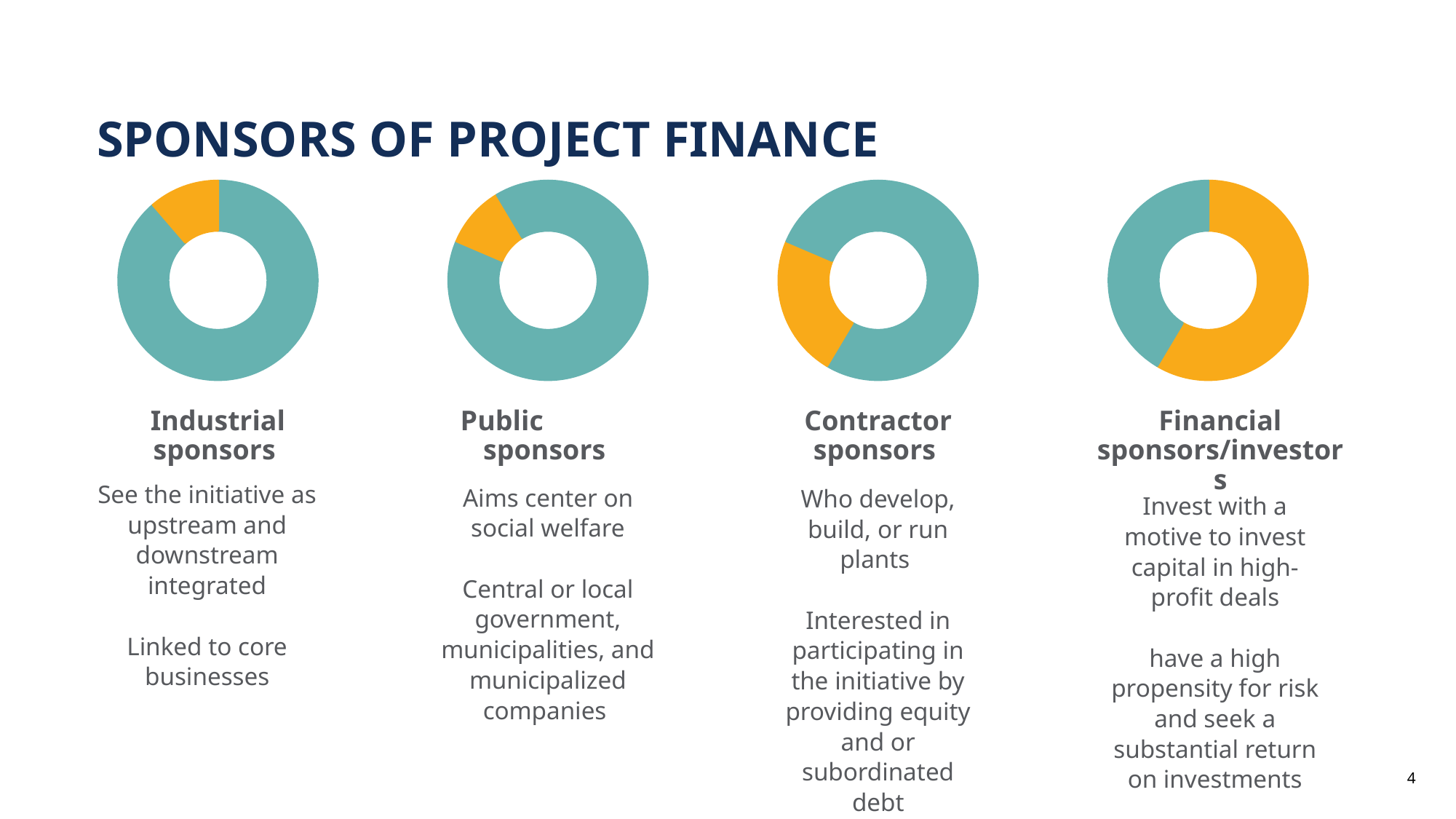
In the 'Contractor sponsors' chart, which slice is larger, the teal one or the orange one? teal Which of the four doughnut charts has the smallest teal slice? Financial sponsors/investors In the 'Financial sponsors/investors' chart, which slice is larger, the teal one or the orange one? orange In the 'Public sponsors' chart, which slice is larger, the teal one or the orange one? teal How many doughnut charts are on the slide? 4 How many slices does the 'Financial sponsors/investors' doughnut chart have? 2 Which two colours are used for the slices in the doughnut charts? teal and orange Which of the four doughnut charts has the largest orange slice? Financial sponsors/investors What is the title of the slide containing the four doughnut charts? SPONSORS OF PROJECT FINANCE What kind of chart is shown above the label 'Industrial sponsors'? doughnut chart